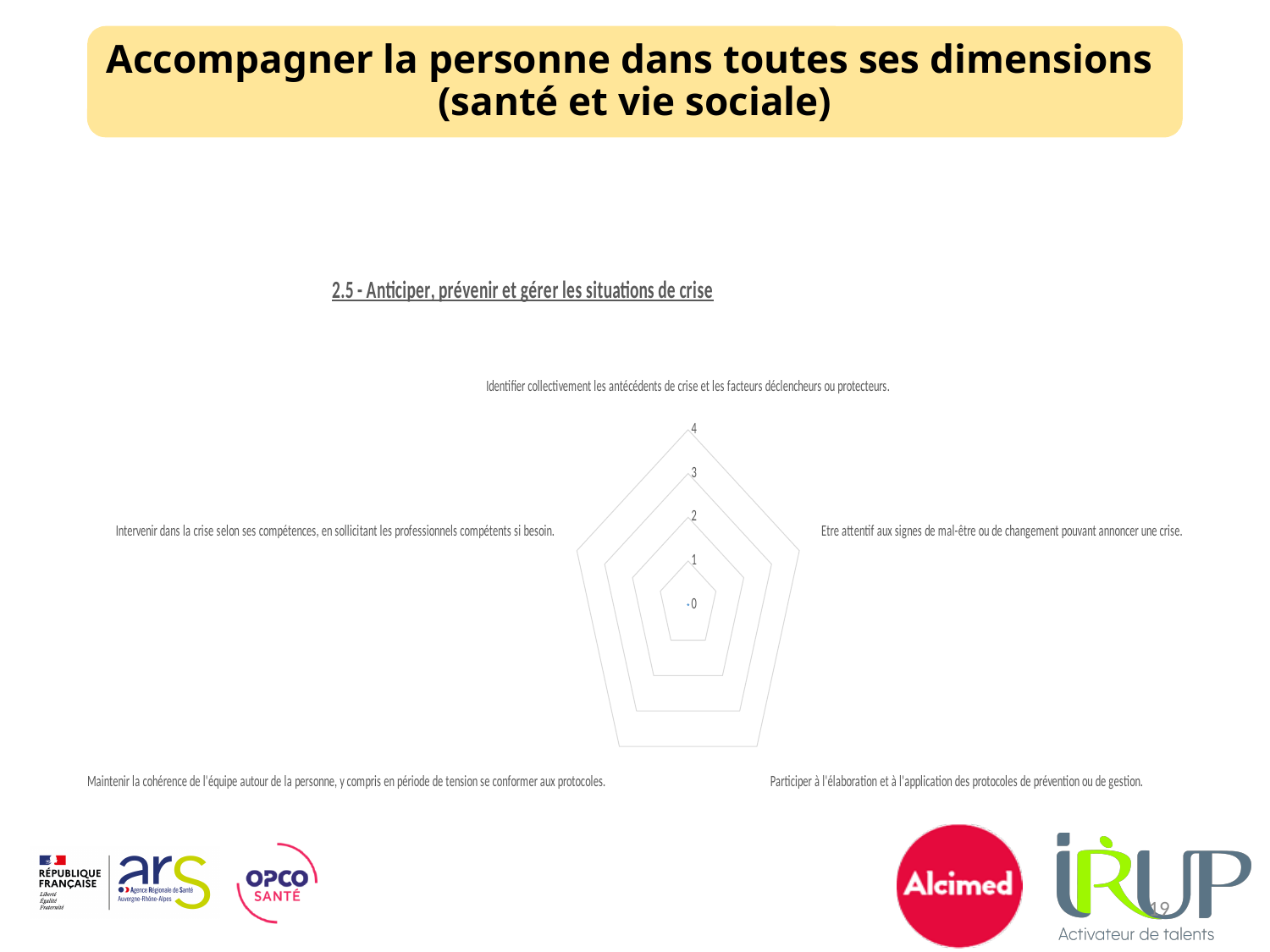
What is the maximum value shown on the radar chart's scale? 4 How many tick values are labelled on the radar chart's scale? 5 What kind of chart is shown on the slide? Radar chart What is the title of the radar chart? 2.5 - Anticiper, prévenir et gérer les situations de crise Which category label appears on the left side of the radar chart? Intervenir dans la crise selon ses compétences, en sollicitant les professionnels compétents si besoin. Which category label appears at the top of the radar chart? Identifier collectivement les antécédents de crise et les facteurs déclencheurs ou protecteurs. How many categories (axes) does the radar chart have? 5 Which category label appears on the right side of the radar chart? Etre attentif aux signes de mal-être ou de changement pouvant annoncer une crise. What is the minimum value shown on the radar chart's scale? 0